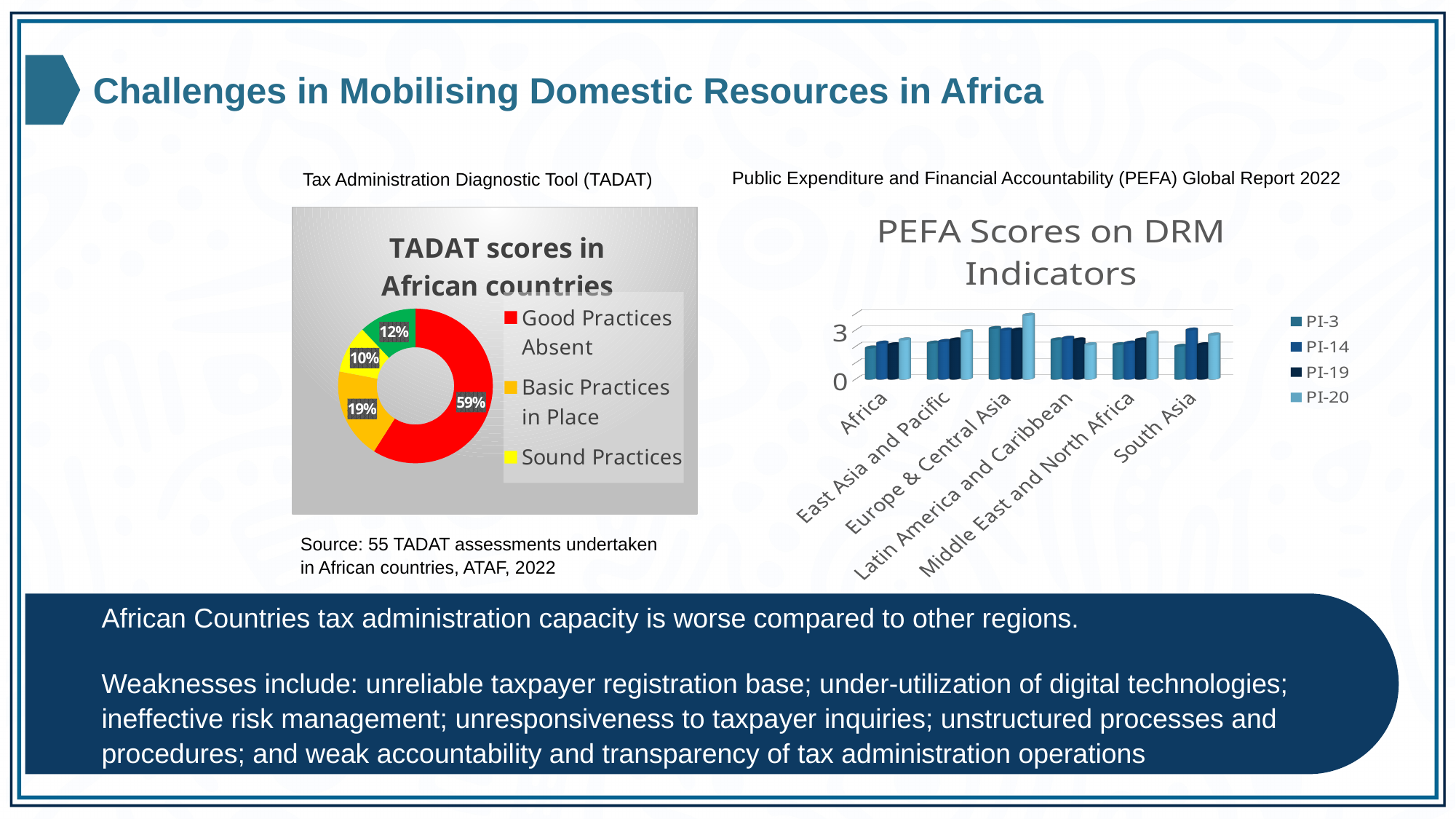
In the PEFA Scores on DRM Indicators chart, how many regions are shown on the x axis? 6 In the TADAT scores in African countries chart, what percentage is shown for Basic Practices in Place? 19% In the TADAT scores in African countries chart, what percentage is shown for Sound Practices? 10% In the PEFA Scores on DRM Indicators chart, how many series does the legend list? 4 In the TADAT scores in African countries chart, which is larger: Basic Practices in Place or Sound Practices? Basic Practices in Place In the TADAT scores in African countries chart, what percentage is shown for Good Practices Absent? 59% In the PEFA Scores on DRM Indicators chart, is the PI-3 value for Africa greater or less than 3? less What kind of chart is the PEFA Scores on DRM Indicators chart? Bar chart What kind of chart is the TADAT scores in African countries chart? Donut (pie) chart In the TADAT scores in African countries chart, what is the difference in percentage points between Good Practices Absent and Basic Practices in Place? 40 In the TADAT scores in African countries chart, which legend category has the largest share? Good Practices Absent In the PEFA Scores on DRM Indicators chart, is the PI-20 value for Europe & Central Asia greater or less than 3? greater